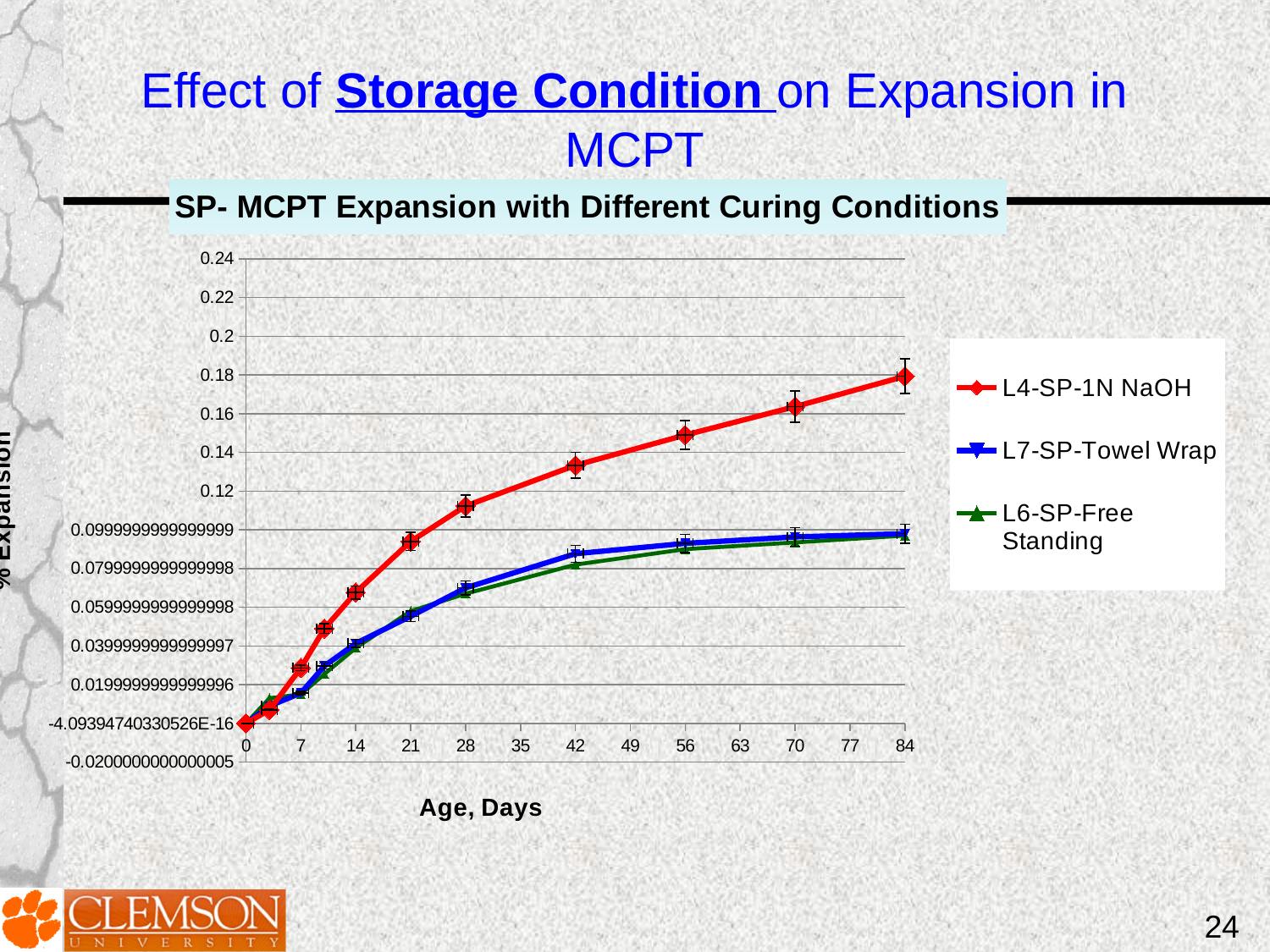
At 84 days, which is larger: L4-SP-1N NaOH or L7-SP-Towel Wrap? L4-SP-1N NaOH What is the title of the chart? SP- MCPT Expansion with Different Curing Conditions Which series has the highest value at 84 days? L4-SP-1N NaOH Is the value for L4-SP-1N NaOH at 84 days greater or less than 0.16? greater What kind of chart is shown on the slide? line chart At 28 days, which is larger: L4-SP-1N NaOH or L6-SP-Free Standing? L4-SP-1N NaOH Is the value for L7-SP-Towel Wrap at 84 days greater or less than 0.12? less Is the value for L6-SP-Free Standing at 14 days greater or less than 0.06? less What is the label of the x axis? Age, Days Do the values for L4-SP-1N NaOH rise or fall as age increases? rise How many series does the legend list? 3